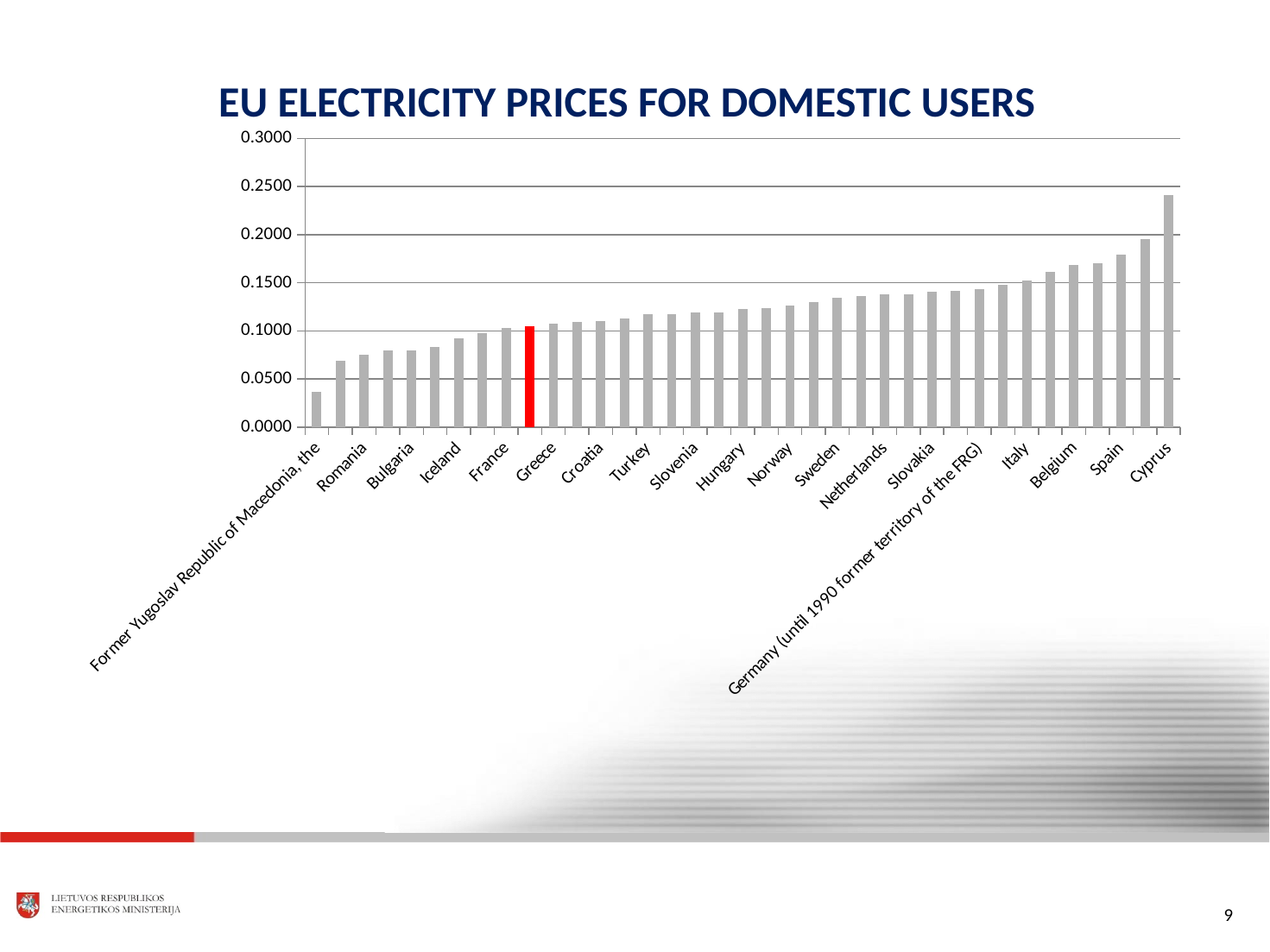
Is the value for Spain greater or less than 0.1500? greater Is the value for Romania greater or less than 0.1000? less What is the title of the chart? EU ELECTRICITY PRICES FOR DOMESTIC USERS Which has the larger value, Belgium or Norway? Belgium Which category has the lowest electricity price in the chart? Former Yugoslav Republic of Macedonia, the What kind of chart is shown on the slide? bar chart Is the value for Former Yugoslav Republic of Macedonia, the greater or less than 0.0500? less What colour is the single highlighted bar in the chart? red Which country has the highest electricity price in the chart? Cyprus Do the values generally rise or fall from left to right along the x axis? rise